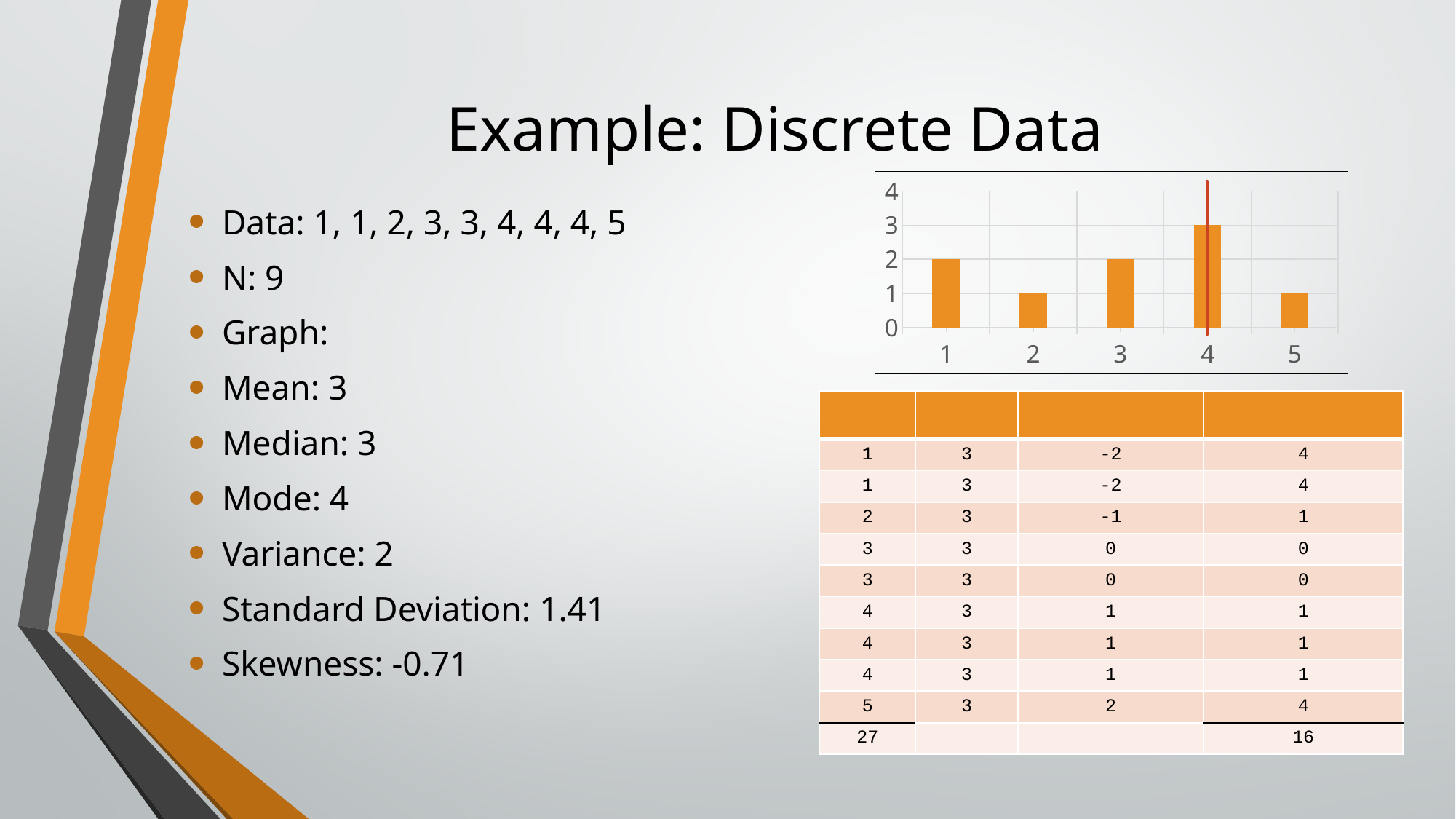
What is the highest value shown on the chart's vertical axis? 4 What is the value of the bar for category 4? 3 What is the value of the bar for category 5? 1 What is the value of the bar for category 2? 1 What is the value of the bar for category 1? 2 Is the value for category 4 greater or less than 2? greater At which category is the red vertical line drawn on the chart? 4 Which category has the highest bar? 4 How many bars (categories) does the chart show? 5 Which is larger, the bar for category 3 or the bar for category 5? category 3 What is the difference between the bar for category 4 and the bar for category 2? 2 What kind of chart is shown on the slide? bar chart